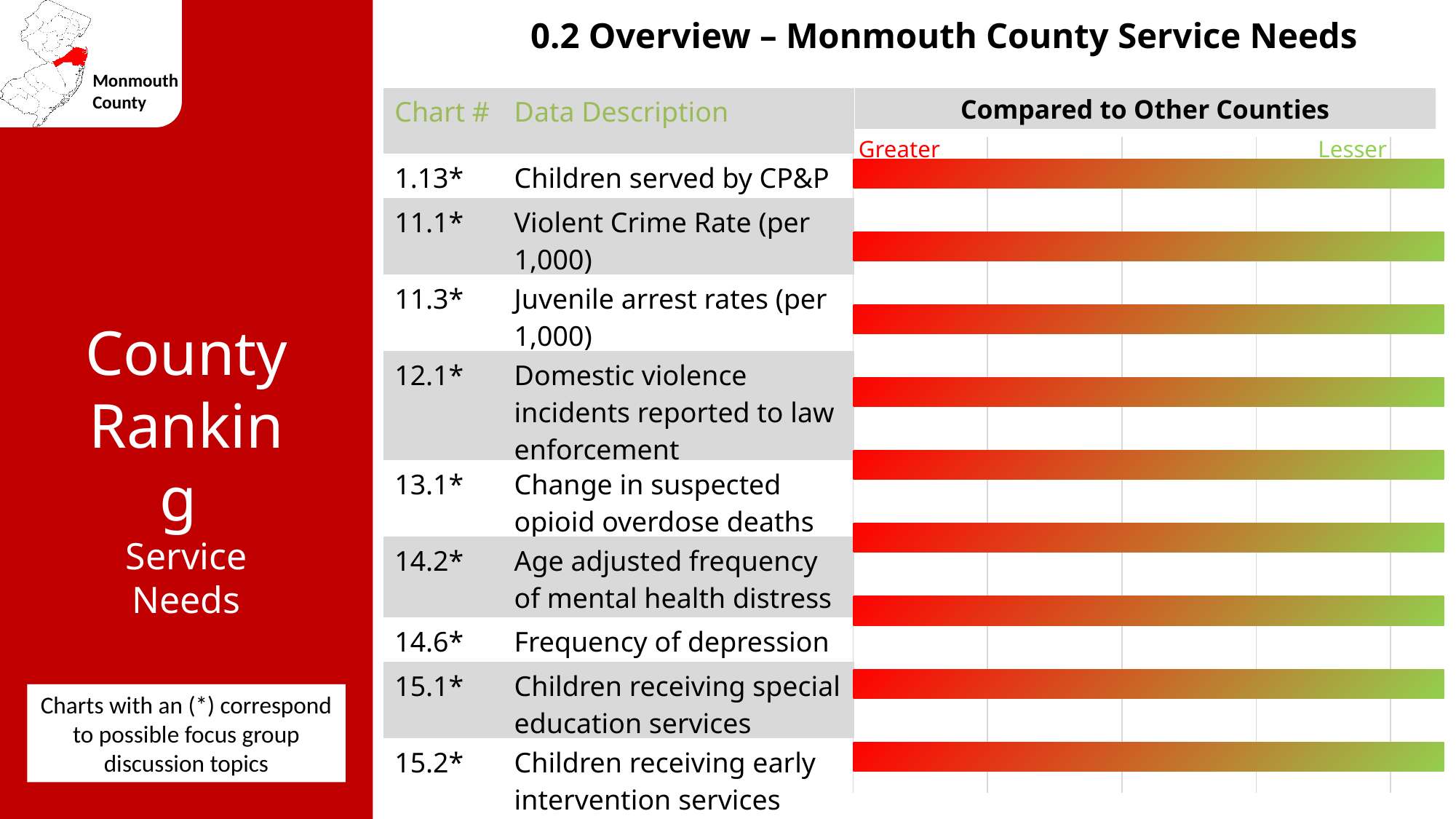
What label appears at the left end of the bars in the 'Compared to Other Counties' chart? Greater What is the title of the chart on the right side of the slide? Compared to Other Counties How many data description rows (bars) are shown in the 'Compared to Other Counties' chart? 9 Which data description is listed for chart number 15.2* in the table? Children receiving early intervention services What kind of chart is shown under 'Compared to Other Counties'? bar chart Which chart number corresponds to 'Frequency of depression' in the table? 14.6* Which chart number corresponds to 'Children served by CP&P' in the table? 1.13* Which data description is listed for chart number 13.1* in the table? Change in suspected opioid overdose deaths